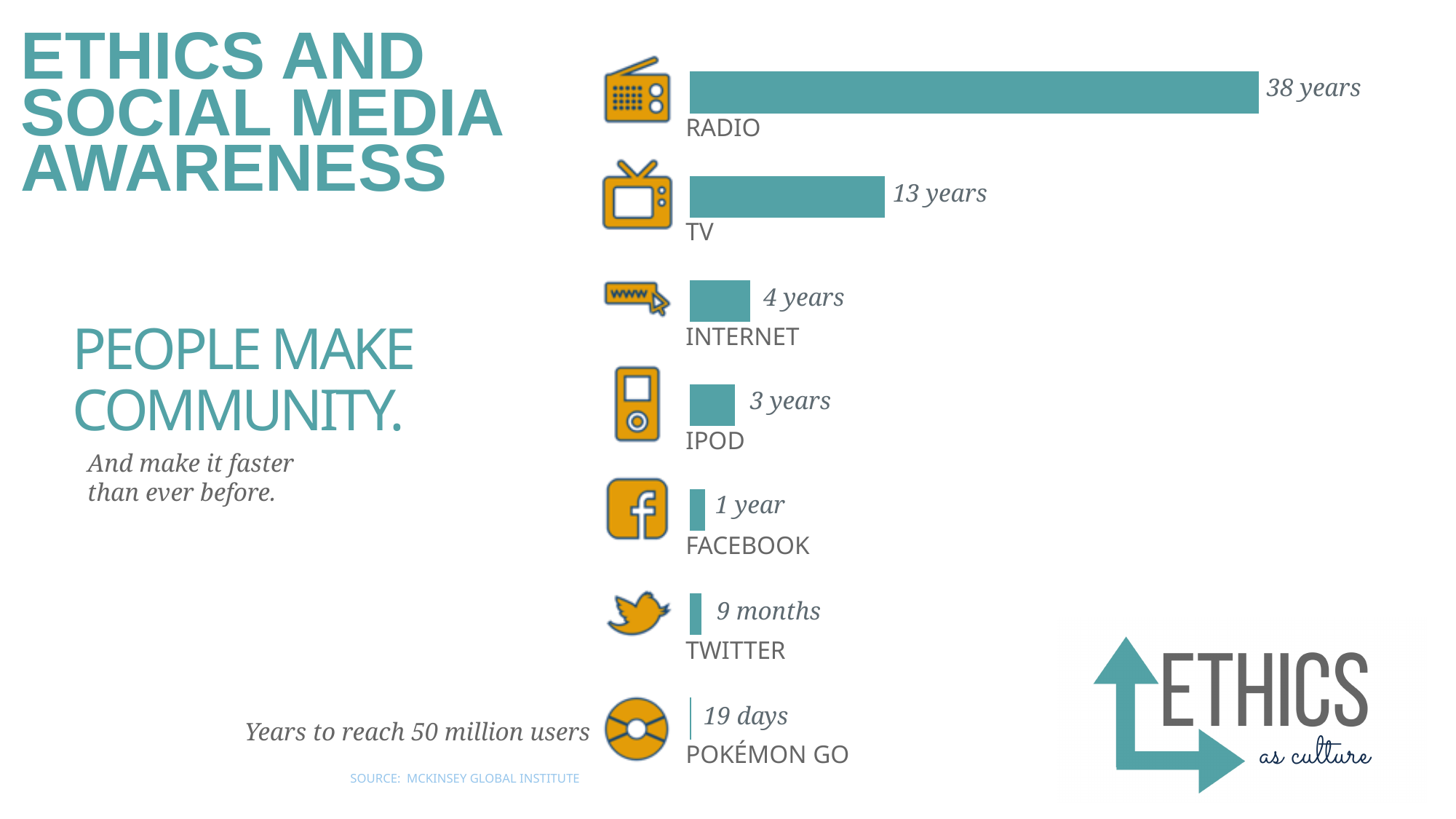
Which category took the shortest time to reach 50 million users? Pokémon Go What kind of chart is shown on the slide? Bar chart Which took longer to reach 50 million users, the Internet or the iPod? Internet How many categories are shown in the chart? 7 How long did it take TV to reach 50 million users? 13 years Which category took the longest to reach 50 million users? Radio How long did it take Facebook to reach 50 million users? 1 year How long did it take the Internet to reach 50 million users? 4 years How long did it take Twitter to reach 50 million users? 9 months How many years did it take radio to reach 50 million users? 38 years How long did it take Pokémon Go to reach 50 million users? 19 days How many more years did radio take than TV to reach 50 million users? 25 years